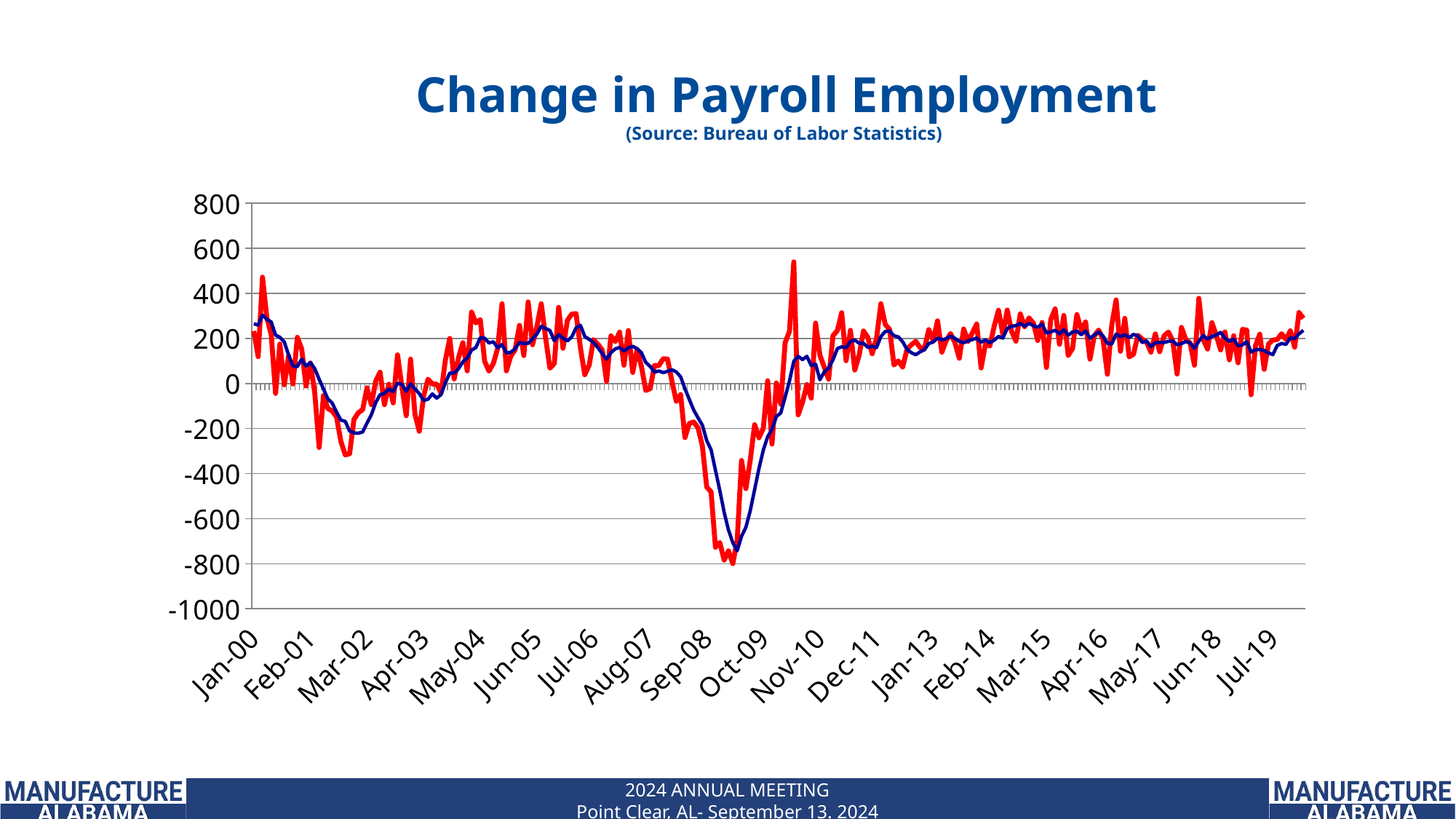
What is the lowest value shown on the y axis? -1000 What is the highest value shown on the y axis? 800 Is the lowest value of the red line near Oct-09 greater or less than -600? less Is the value of the blue line at Jun-05 greater or less than 0? greater What is the title of the chart? Change in Payroll Employment How many lines are plotted on the chart? 2 What kind of chart is shown on the slide? line chart How many date labels are shown along the x axis? 19 What source is cited under the chart title? Bureau of Labor Statistics